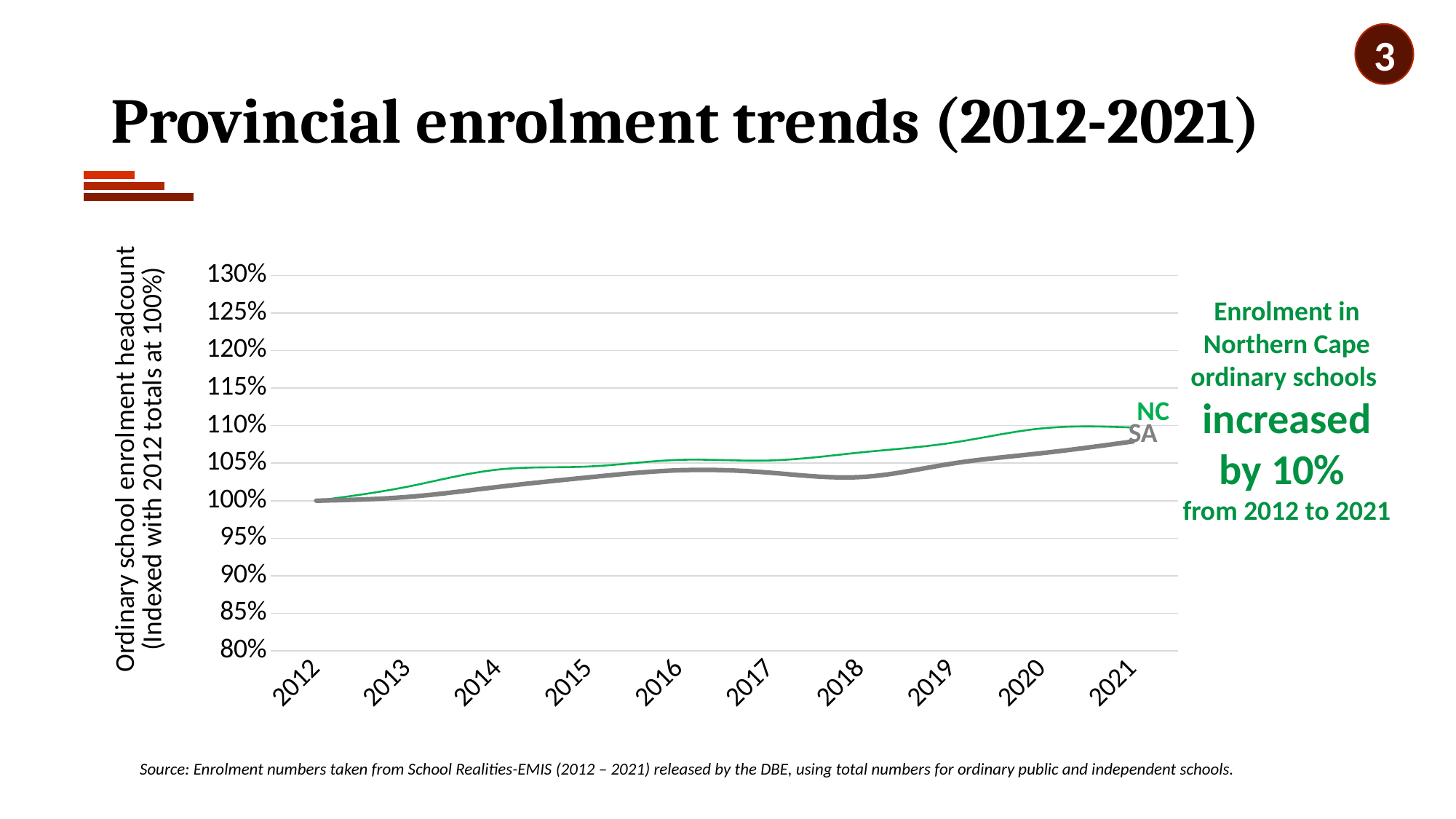
What is the indexed enrolment value for NC in 2012? 100% Is the value for NC in 2014 greater or less than 100%? greater How many series are plotted on the chart? 2 What kind of chart is shown on the slide? line chart How many years are shown on the x axis of the chart? 10 What is the title of the slide containing the chart? Provincial enrolment trends (2012-2021) According to the slide, by how much did enrolment in Northern Cape ordinary schools increase from 2012 to 2021? 10% Is the value for SA in 2021 greater or less than 105%? greater What colour is the NC line on the chart? green In 2021, which series has the higher value, NC or SA? NC Is the value for SA in 2018 greater or less than 105%? less Does the NC line generally rise or fall from 2012 to 2021? rise